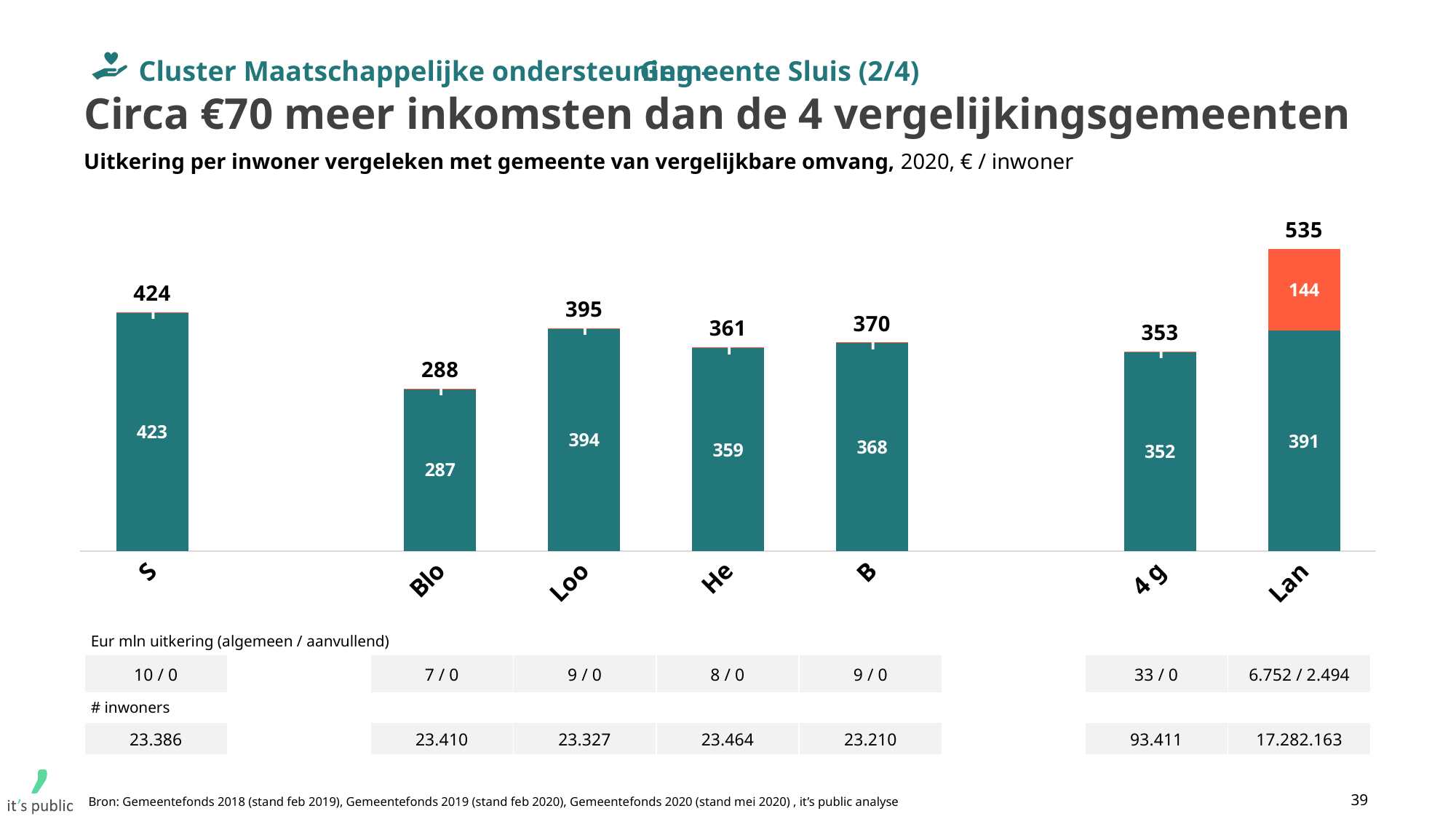
Which category has the lowest total value? Blo What is the total value shown above the bar for 4 g? 353 What is the value of the teal segment of the bar for S? 423 What is the difference between the total values for B and He? 9 What is the value of the orange segment of the bar for Lan? 144 What is the total of the stacked bar for Lan, adding the teal segment 391 and the orange segment 144? 535 What is the difference between the total values for S and Blo? 136 Which has a larger total value, Loo or He? Loo What kind of chart is shown on the slide? Stacked bar chart How many categories are shown on the x axis of the chart? 7 Which category has the highest total value? Lan What is the total value shown above the bar for Lan? 535